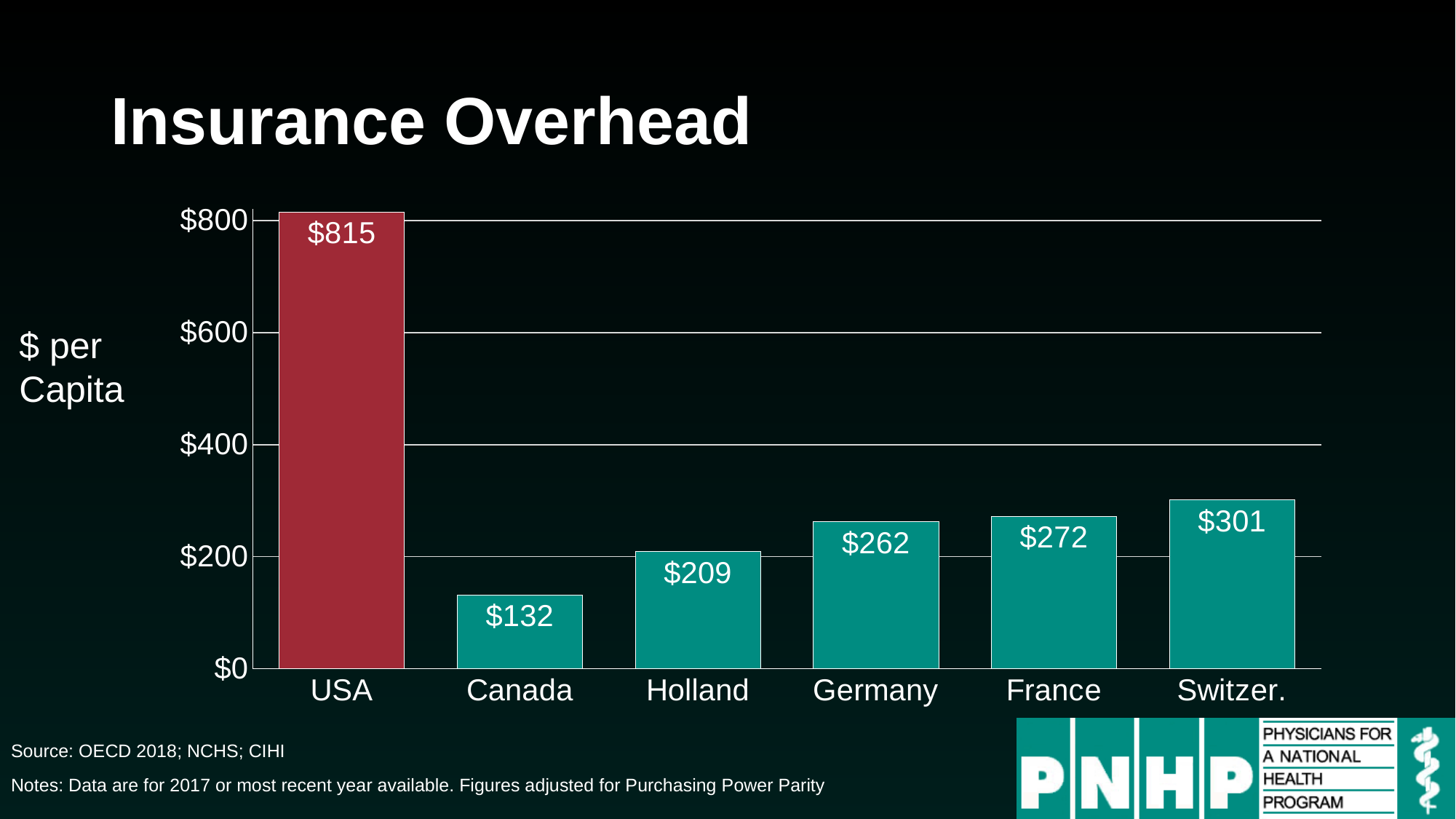
What is the title of the chart? Insurance Overhead What is the insurance overhead per capita for Canada? $132 Which country has the highest insurance overhead per capita? USA How many countries are shown in the chart? 6 What is the difference in insurance overhead per capita between the USA and Canada? $683 What is the insurance overhead per capita for Germany? $262 Is the value for France greater or less than $200? greater What is the insurance overhead per capita for the USA? $815 Which country has the lowest insurance overhead per capita? Canada What is the difference in insurance overhead per capita between Switzerland and France? $29 Which has a higher insurance overhead per capita, Holland or Germany? Germany What kind of chart is shown on the slide? Bar chart